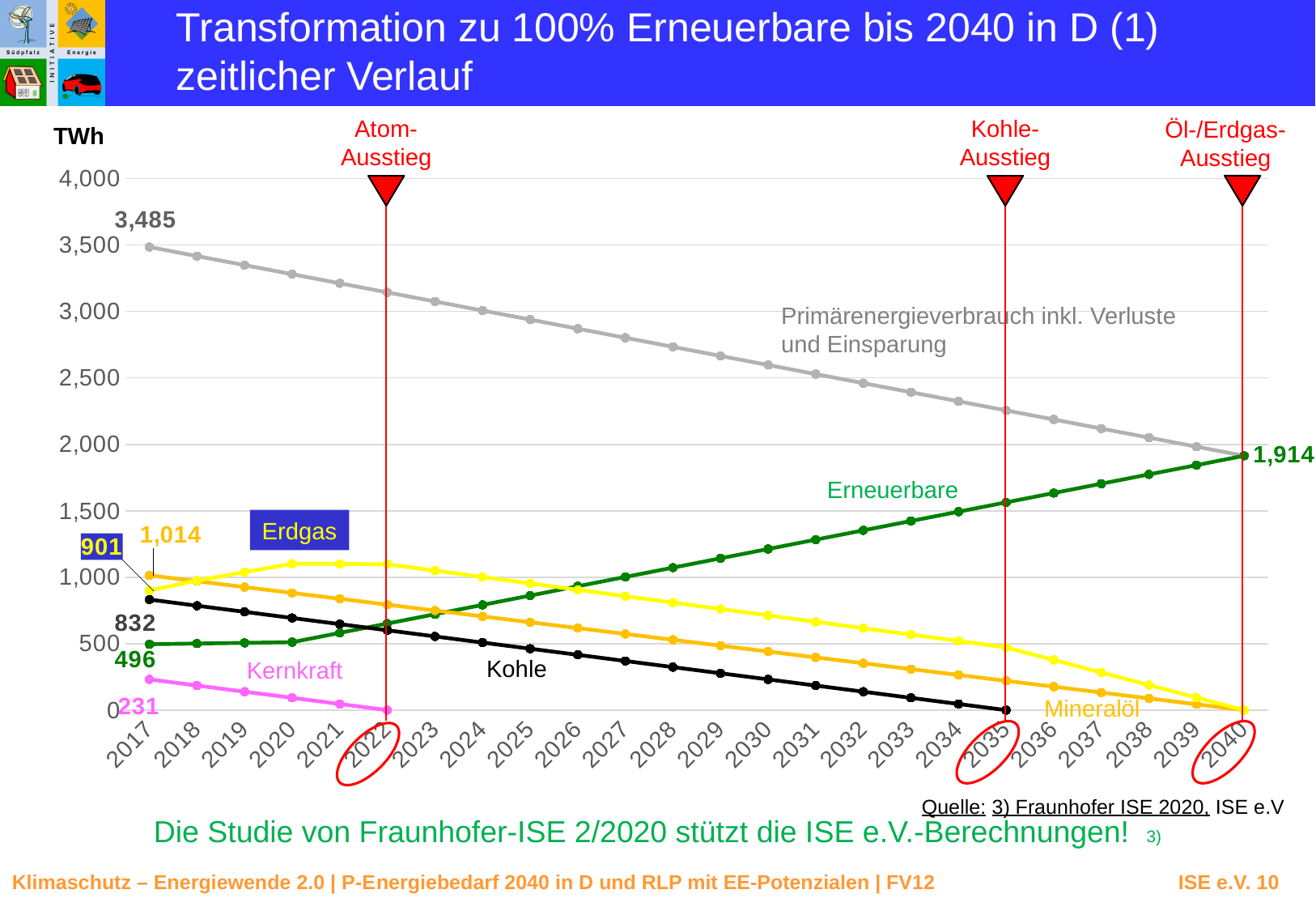
What is the value of Kohle in 2017? 832 Does the Primärenergieverbrauch line rise or fall from 2017 to 2040? fall What is the value of Primärenergieverbrauch inkl. Verluste und Einsparung in 2017? 3,485 By how much does Erneuerbare increase from 2017 to 2040? 1,418 What is the value of Kernkraft in 2017? 231 What type of chart is shown on the slide? line chart In which year does the Kernkraft line reach zero (Atom-Ausstieg)? 2022 Which series has the highest value in 2017? Primärenergieverbrauch inkl. Verluste und Einsparung Is the value of Erneuerbare in 2035 greater or less than 1,500? greater What is the value of Erneuerbare in 2017? 496 What is the value of Mineralöl in 2017? 1,014 What is the value of Erneuerbare in 2040? 1,914